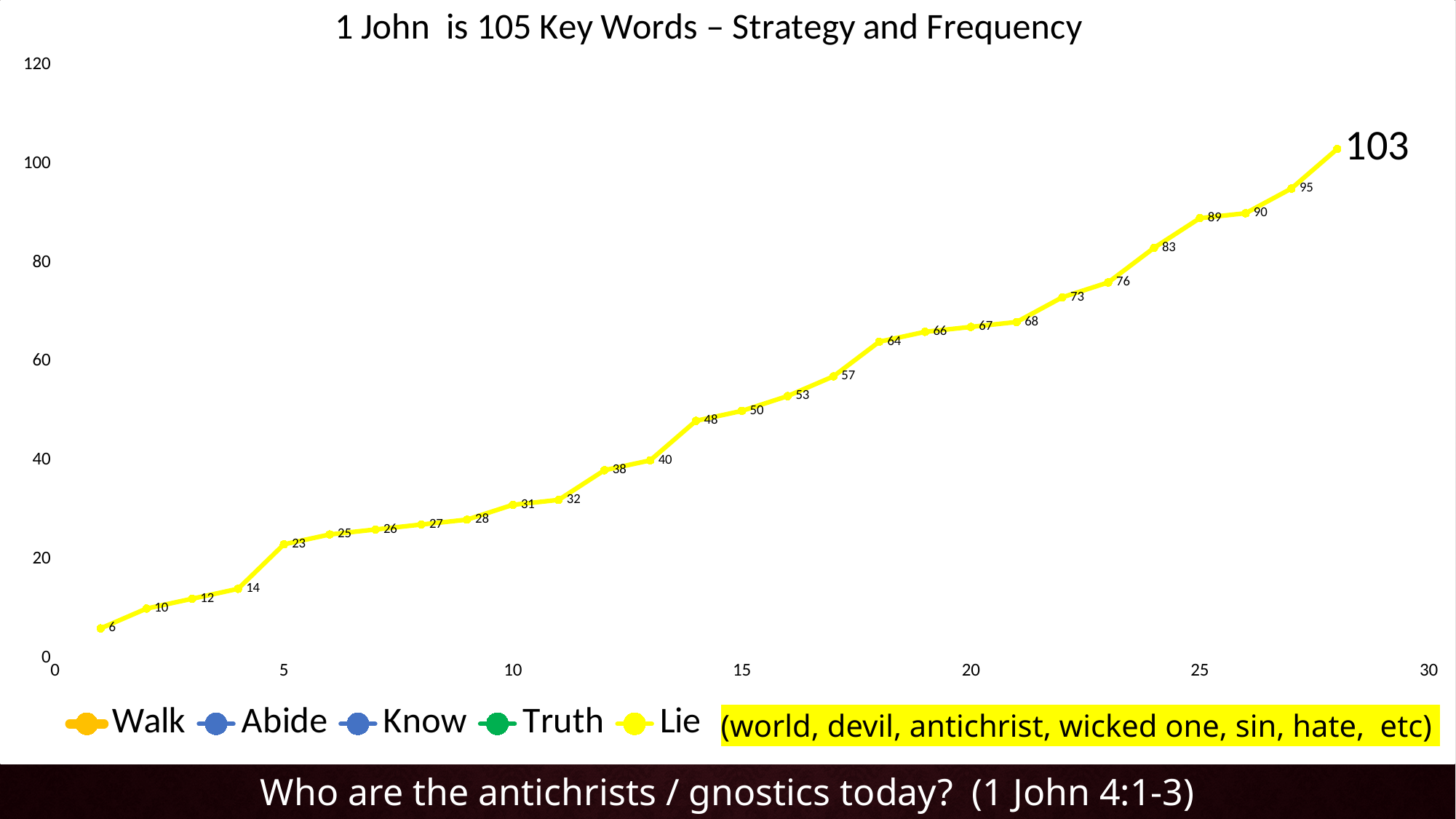
What kind of chart is shown on the slide? line chart What is the value of the Lie series at x = 25? 89 What colour is the Lie series in the legend? yellow What is the value of the Lie series at x = 5? 23 What is the highest value plotted on the Lie line? 103 Do the values of the Lie series rise or fall along the x axis? rise How many series does the legend list? 5 What is the value of the Lie series at x = 10? 31 What is the lowest value plotted on the Lie line? 6 What is the value of the Lie series at x = 20? 67 How many data points are plotted on the Lie line? 28 What is the difference between the highest and lowest values on the Lie line? 97